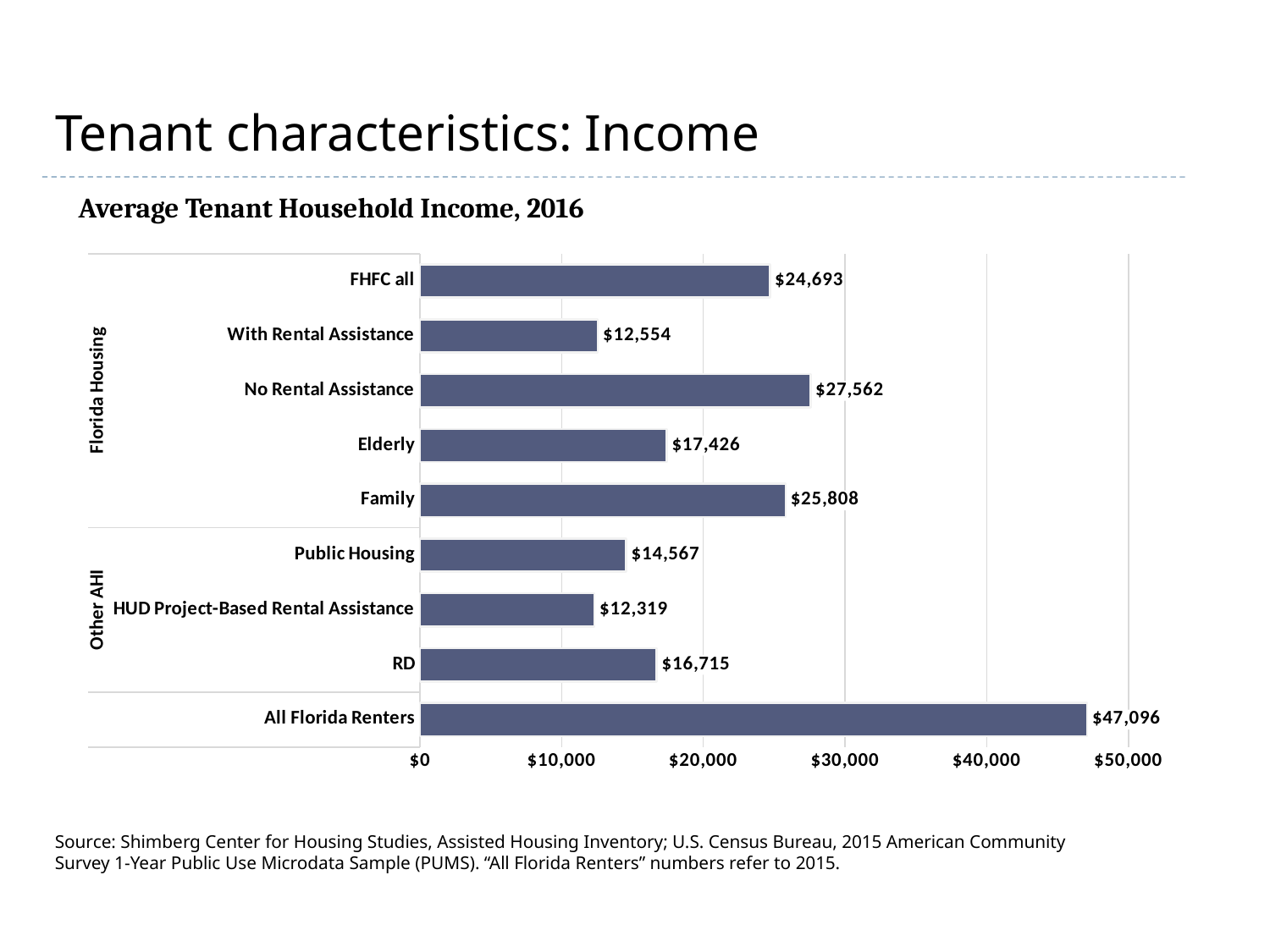
Which category has the highest average tenant household income? All Florida Renters What is the title of the chart? Average Tenant Household Income, 2016 Which category has the lowest average tenant household income? HUD Project-Based Rental Assistance What kind of chart is shown on the slide? Bar chart What is the difference between the average income for All Florida Renters and FHFC all? $22,403 What is the average tenant household income for All Florida Renters? $47,096 What is the average tenant household income for FHFC all? $24,693 What is the difference between the average income for No Rental Assistance and With Rental Assistance? $15,008 Is the value for RD greater or less than $20,000? less Which has a higher average tenant household income, Elderly or Family? Family What is the average tenant household income for Public Housing? $14,567 How many categories are shown in the chart? 9